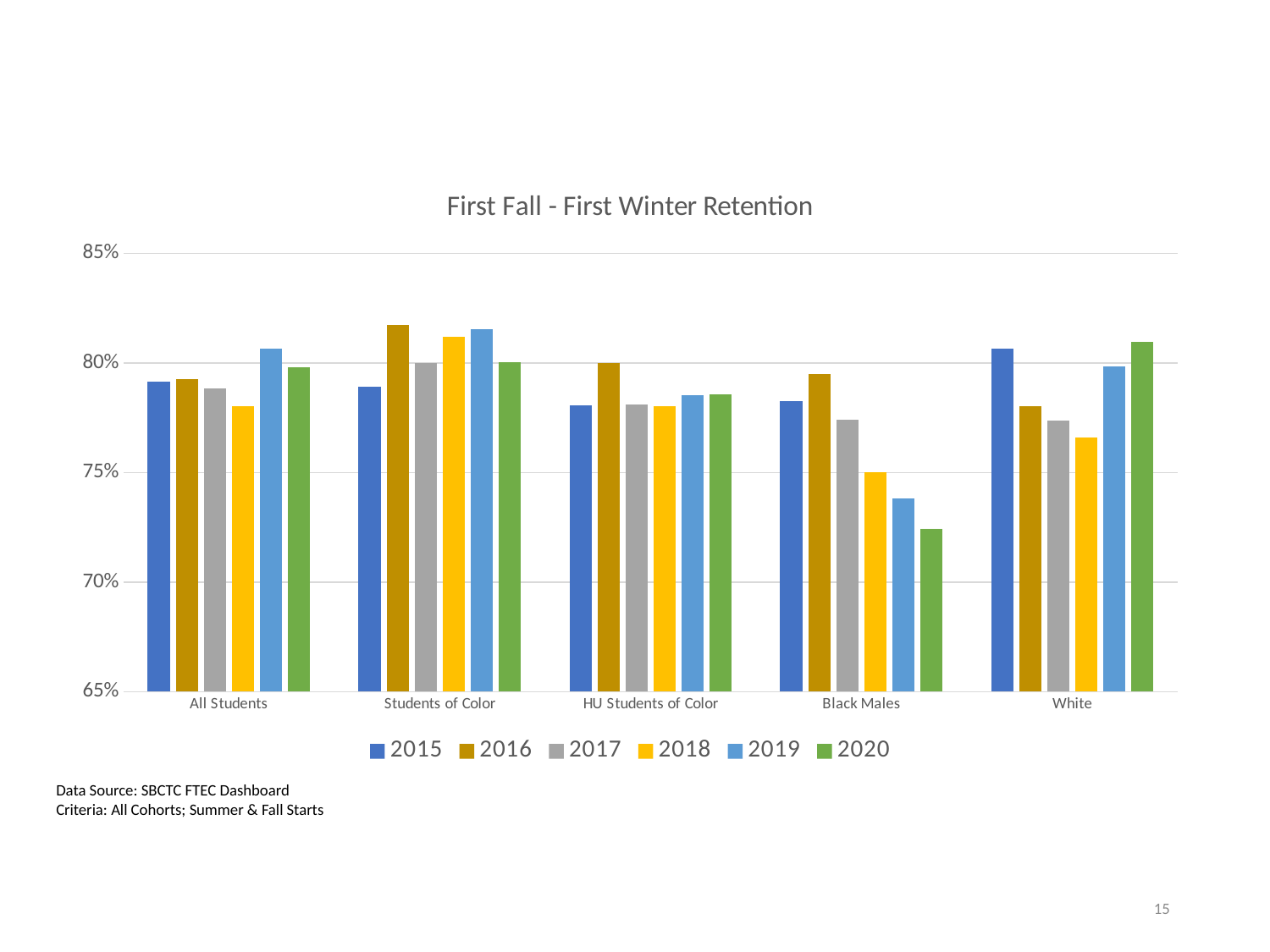
Which colour represents the 2018 series in the legend? Yellow What is the title of the chart? First Fall - First Winter Retention How many student groups (categories) are shown on the x axis? 5 For Black Males, which year has the highest retention? 2016 For White students, which is larger: the 2015 value or the 2018 value? 2015 Is the value for White in 2020 greater or less than 80%? greater How many series does the legend list? 6 For Black Males, which year has the lowest retention? 2020 Is the value for Students of Color in 2016 greater or less than 80%? greater What kind of chart is shown on the slide? Bar chart For Black Males, do the values rise or fall from 2016 to 2020? fall Is the value for Black Males in 2020 greater or less than 75%? less